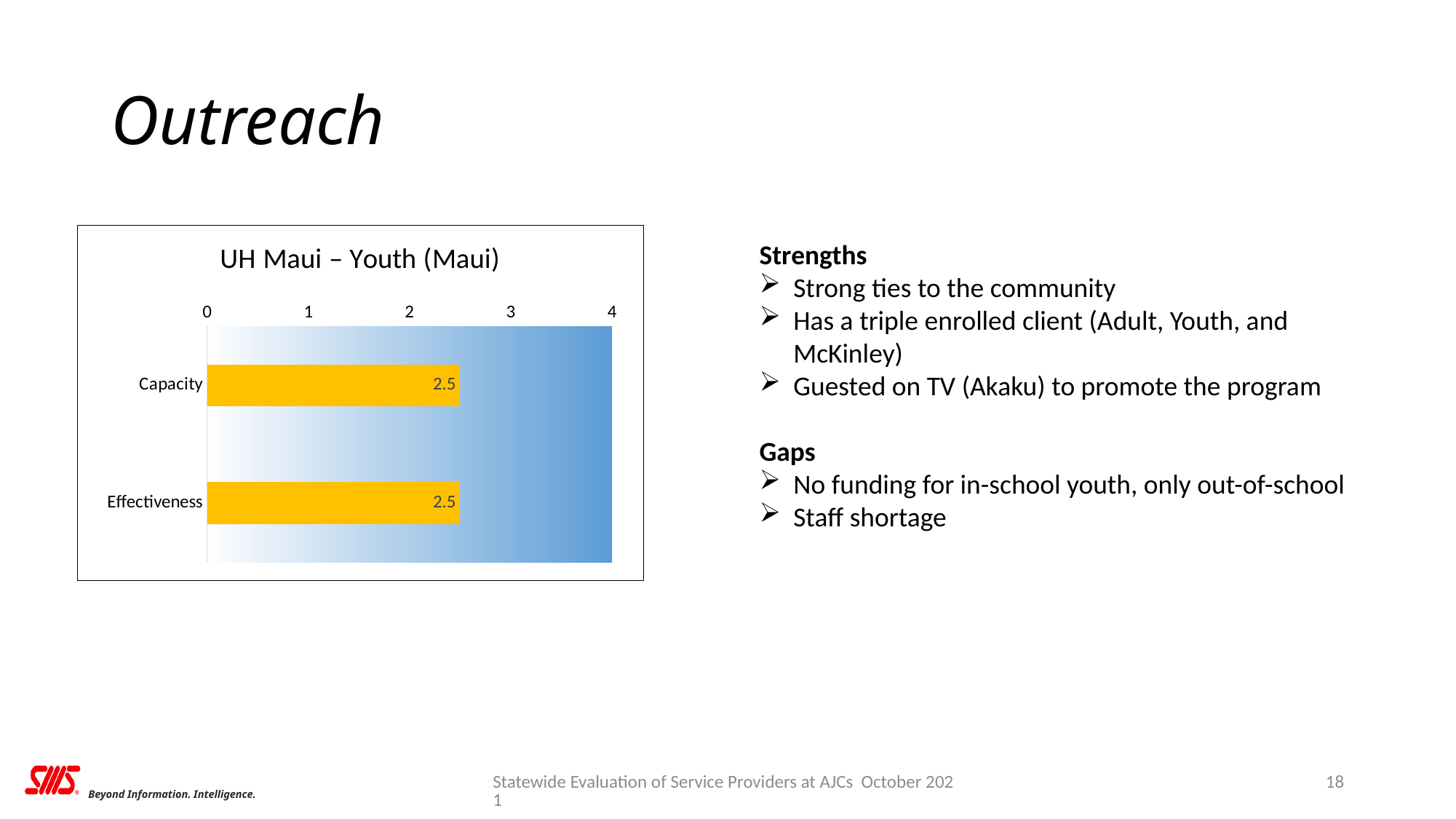
What is the difference between the Capacity and Effectiveness values? 0 What is the maximum value shown on the chart's axis? 4 What kind of chart is shown on the slide? bar chart How many categories are shown in the chart? 2 Is the value for Effectiveness greater or less than 3? less What is the total of the Capacity and Effectiveness values? 5 What is the value for Capacity? 2.5 What is the title of the chart? UH Maui – Youth (Maui) Is the value for Capacity greater or less than 2? greater What is the value for Effectiveness? 2.5